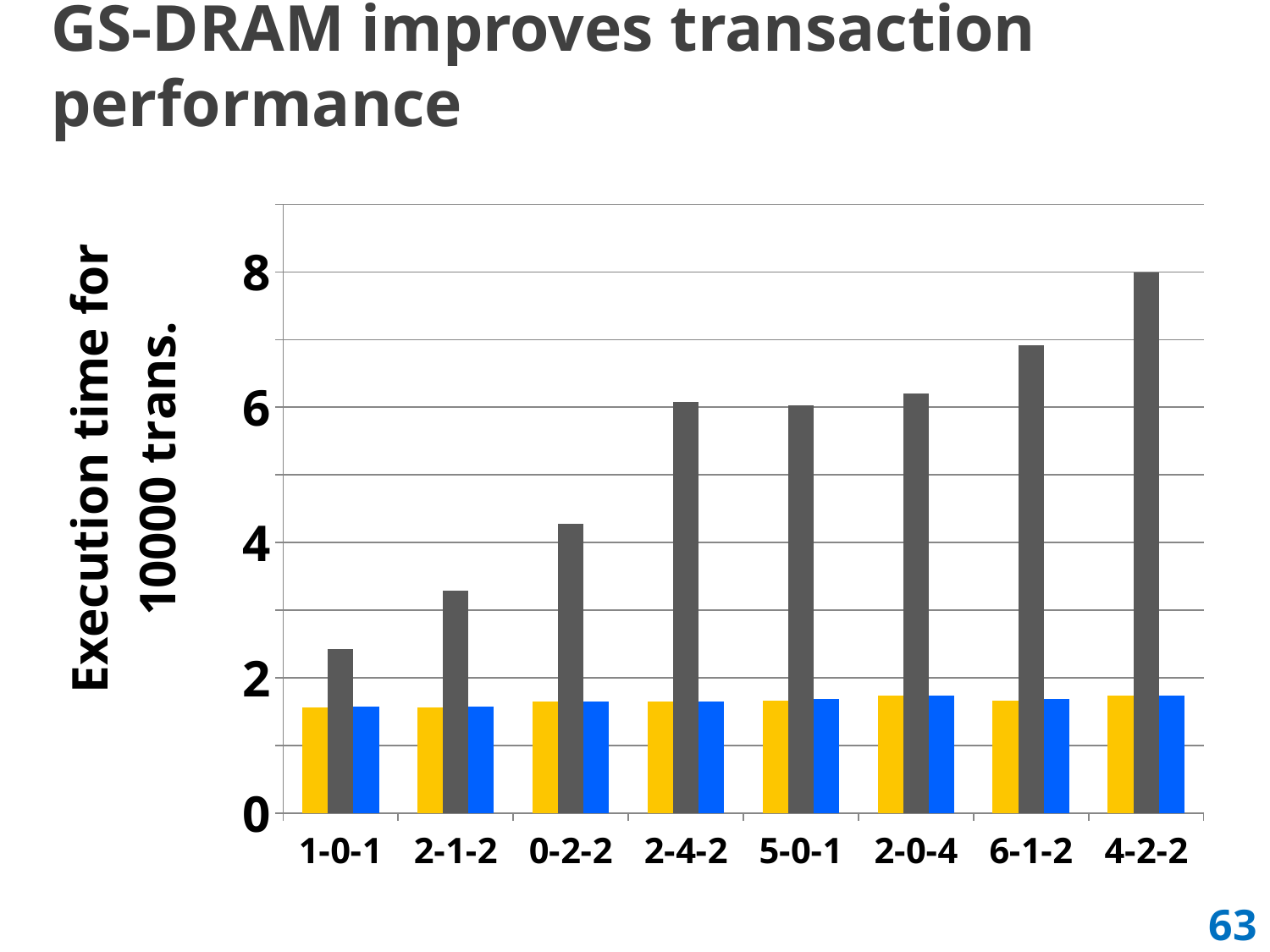
For category 2-4-2, which is larger: the gray bar or the blue bar? the gray bar Which category has the tallest gray bar? 4-2-2 Do the gray bars generally rise or fall from left to right along the x axis? rise Is the gray bar for 0-2-2 greater or less than 4? greater Is the gray bar for 2-1-2 greater or less than 4? less Is the yellow bar for 2-0-4 greater or less than 2? less What kind of chart is shown on the slide? bar chart Which category has the shortest gray bar? 1-0-1 How many categories are shown on the x axis? 8 What is the label on the y axis? Execution time for 10000 trans. What is the title of the slide's chart? GS-DRAM improves transaction performance